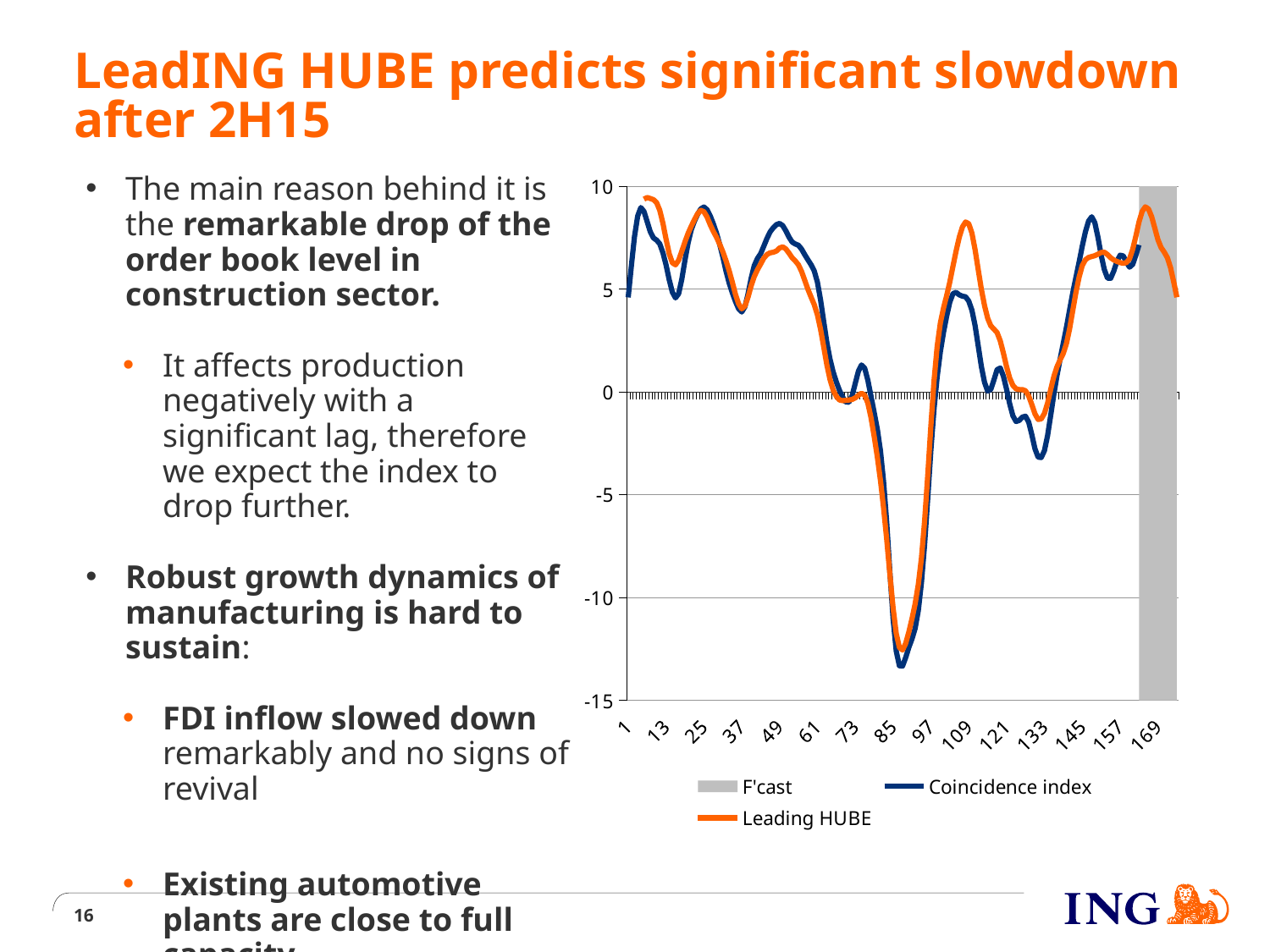
Is the lowest value of the Leading HUBE line greater or less than -10? less Which legend entry is drawn in orange? Leading HUBE What kind of chart is shown on the slide? line chart Is the lowest value of the Coincidence index greater or less than -10? less What is the highest value shown on the y axis? 10 Is the value of the Leading HUBE line at x = 109 greater or less than 5? greater How many entries does the chart legend list? 3 How many tick labels are shown on the x axis? 15 Which legend entry is shown as a grey shaded area? F'cast Does the Leading HUBE line rise or fall within the grey forecast area at the right end of the chart? fall